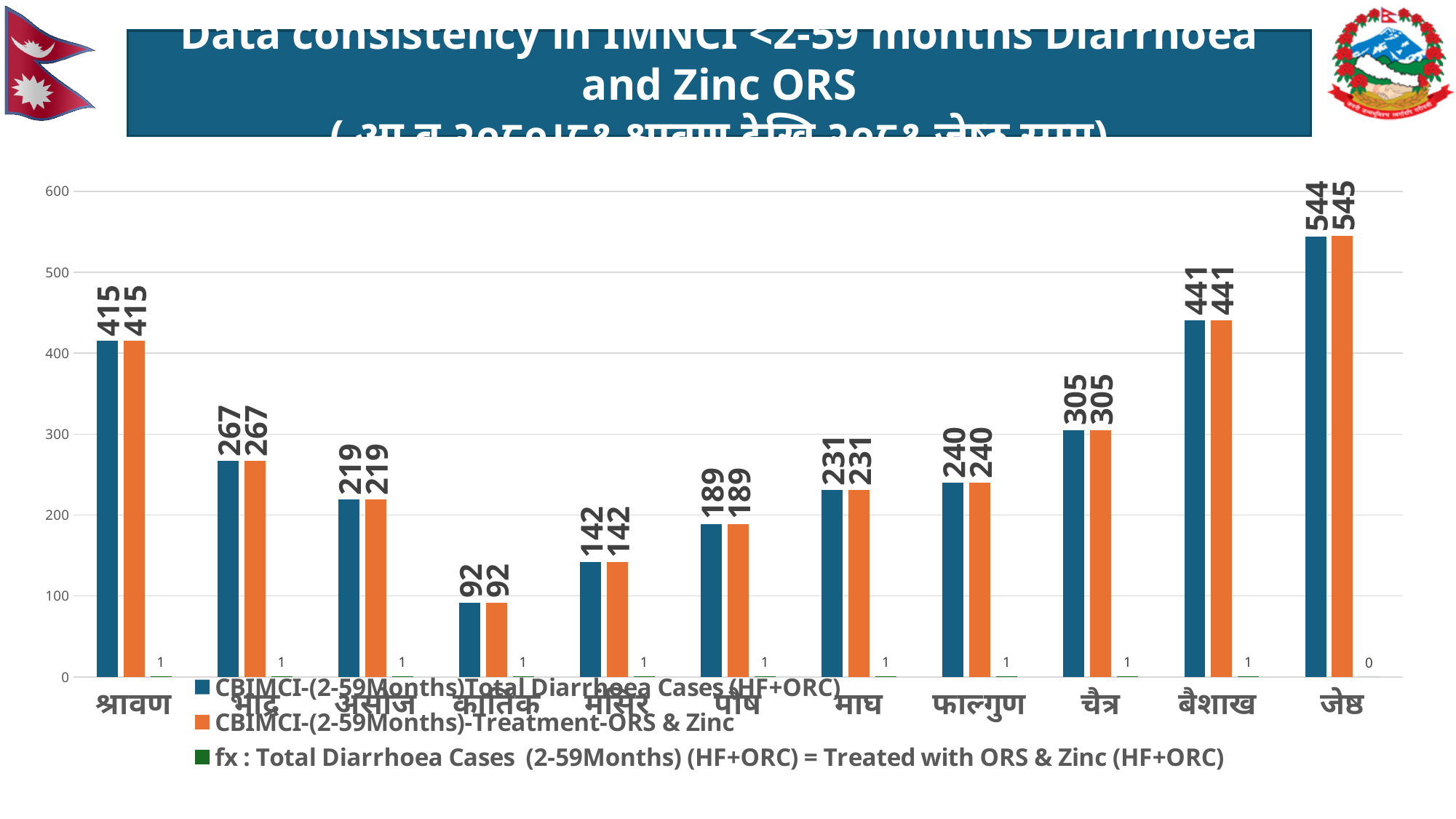
Which is larger, the Total Diarrhoea Cases value for पौष or for माघ? माघ What kind of chart is shown on the slide? bar chart Which month has the highest value for CBIMCI-(2-59Months)Total Diarrhoea Cases (HF+ORC)? जेष्ठ What is the value of the fx series for जेष्ठ? 0 What is the value of CBIMCI-(2-59Months)Total Diarrhoea Cases (HF+ORC) for कार्तिक? 92 Which month has the lowest value for CBIMCI-(2-59Months)-Treatment-ORS & Zinc? कार्तिक What is the value of CBIMCI-(2-59Months)-Treatment-ORS & Zinc for जेष्ठ? 545 How many series does the legend list? 3 What is the difference between the Total Diarrhoea Cases value for बैशाख and for चैत्र? 136 How many month categories are shown on the x axis? 11 What colour represents the CBIMCI-(2-59Months)-Treatment-ORS & Zinc series? orange What is the value of CBIMCI-(2-59Months)Total Diarrhoea Cases (HF+ORC) for श्रावण? 415